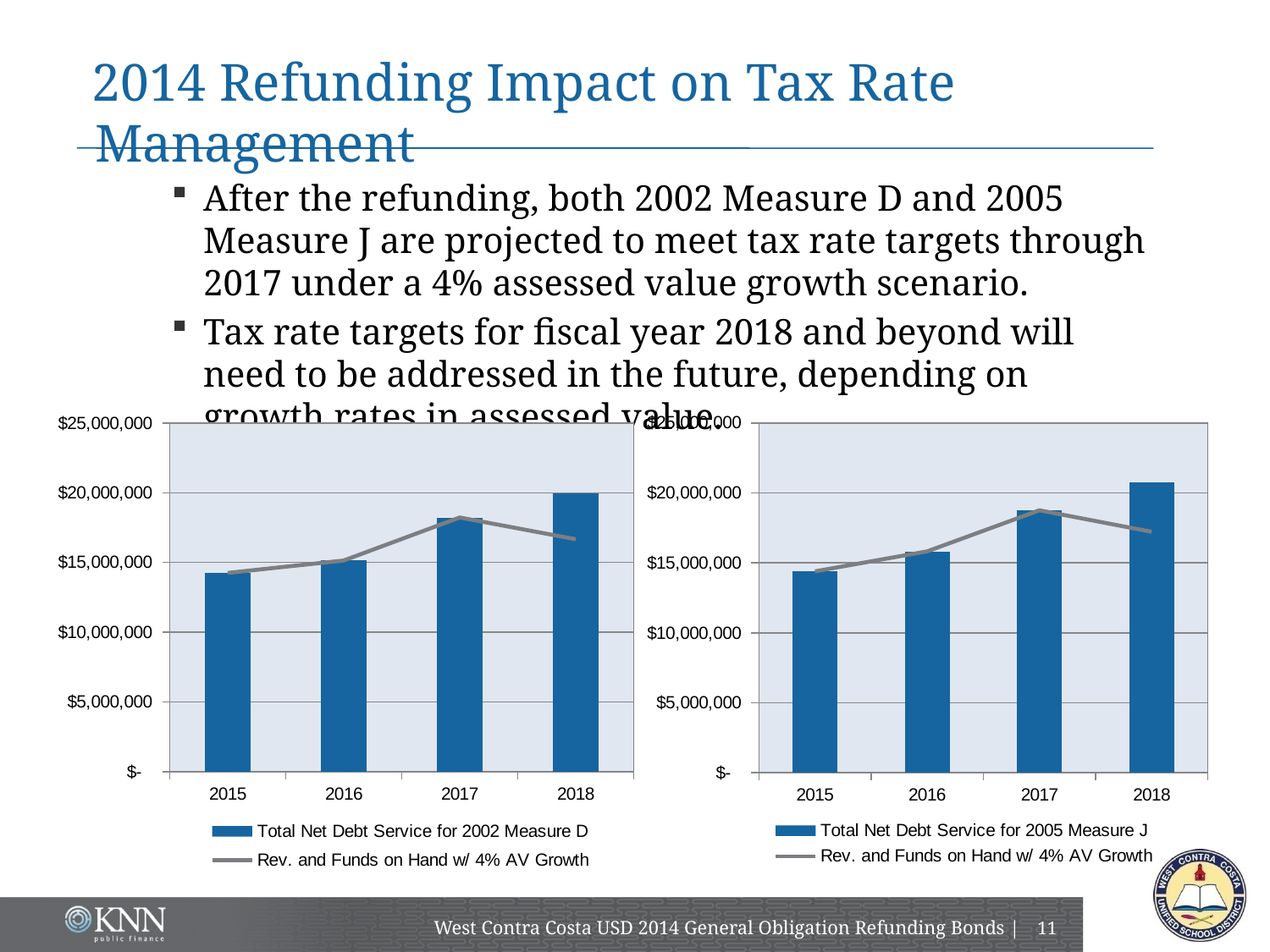
In the left chart (2002 Measure D), is the Total Net Debt Service for 2015 greater or less than $15,000,000? less How many years are shown on the x axis of the right chart (2005 Measure J)? 4 In the right chart (2005 Measure J), which is larger in 2018: the Total Net Debt Service bar or the Rev. and Funds on Hand w/ 4% AV Growth line? Total Net Debt Service bar In the right chart (2005 Measure J), which year has the lowest Total Net Debt Service bar? 2015 In the left chart (2002 Measure D), is the Total Net Debt Service for 2017 greater or less than $15,000,000? greater How many series does the legend of the left chart (2002 Measure D) list? 2 In the left chart (2002 Measure D), does the Rev. and Funds on Hand w/ 4% AV Growth line rise or fall from 2017 to 2018? fall What kind of chart is the left chart (2002 Measure D)? bar chart with a line In the right chart (2005 Measure J), is the Total Net Debt Service for 2018 greater or less than $20,000,000? greater In the left chart (2002 Measure D), which year has the highest Total Net Debt Service bar? 2018 What is the name of the line series in the legend of the right chart (2005 Measure J)? Rev. and Funds on Hand w/ 4% AV Growth In the right chart (2005 Measure J), do the Total Net Debt Service bars rise or fall from 2015 to 2018? rise